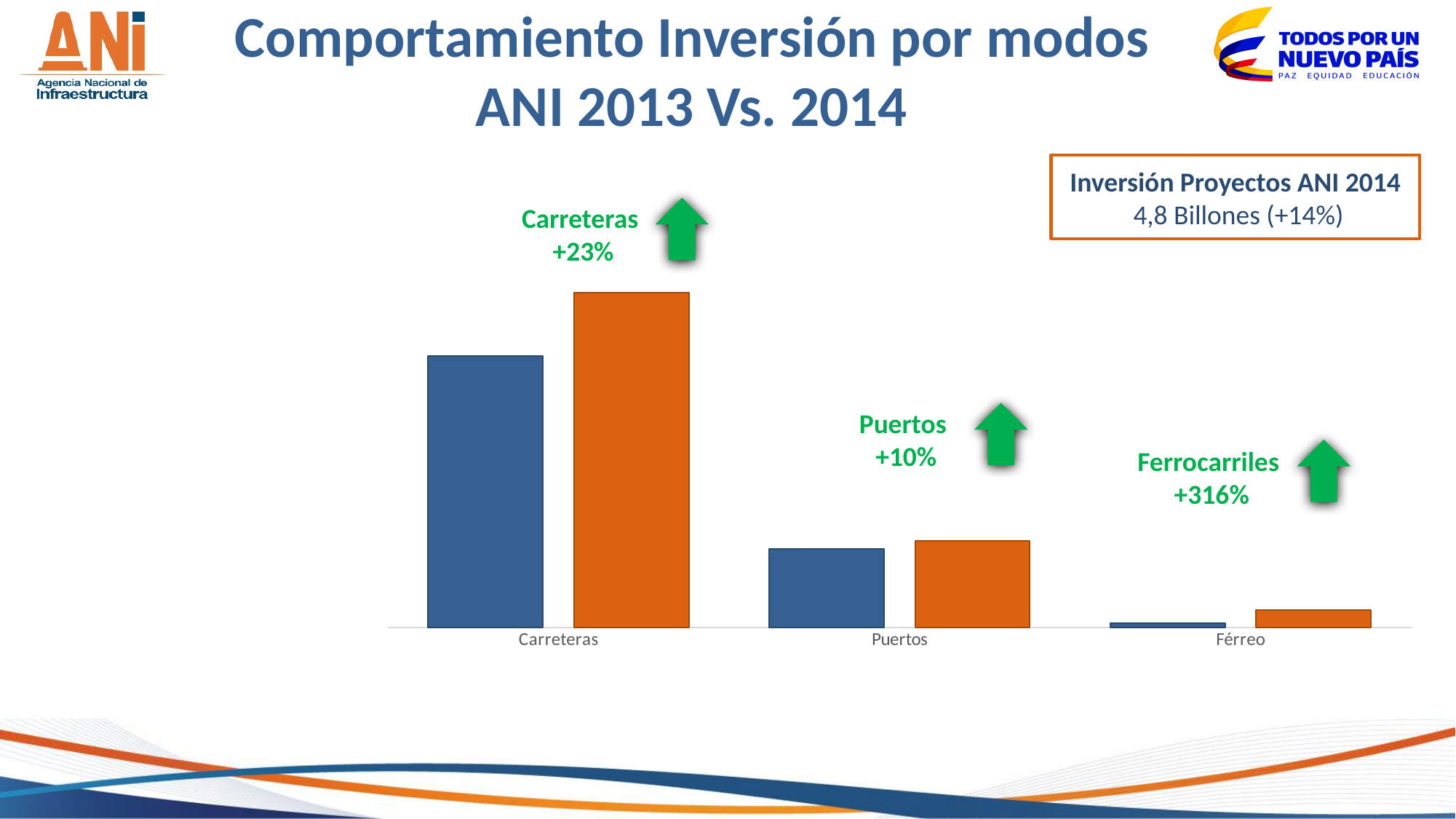
How many bars are shown for each category in the chart? 2 What percentage increase is annotated for Carreteras? +23% What percentage increase is annotated for Puertos? +10% What percentage increase is annotated for Ferrocarriles? +316% What kind of chart is shown on the slide? Bar chart Do the bar heights rise or fall moving from Carreteras to Férreo along the x axis? Fall Which category has the tallest bars in the chart? Carreteras Which category has a taller blue bar, Puertos or Férreo? Puertos How many categories are shown on the x axis of the chart? 3 Which category has the shortest bars in the chart? Férreo For Carreteras, is the orange bar taller or shorter than the blue bar? Taller What is the title of the slide containing the chart? Comportamiento Inversión por modos ANI 2013 Vs. 2014